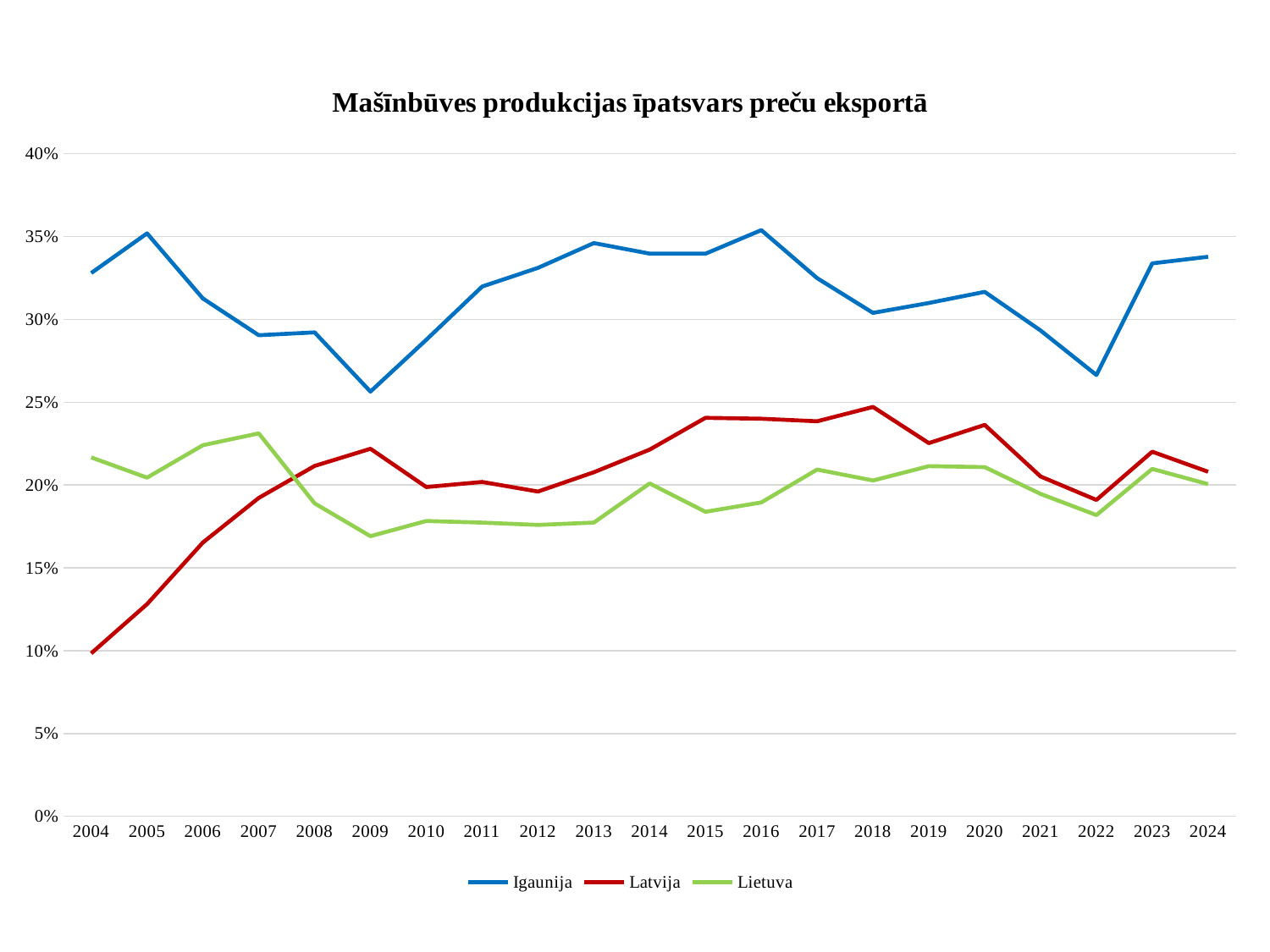
In 2007, which is higher: Latvija or Lietuva? Lietuva In which year is the Latvija line at its lowest? 2004 Does the Latvija line rise or fall from 2004 to 2007? rise In which year is the Igaunija line at its lowest? 2009 What is the title of the chart? Mašīnbūves produkcijas īpatsvars preču eksportā How many years are plotted along the x axis? 21 How many series does the legend list? 3 Is the value for Igaunija in 2009 greater or less than 30%? less Is the value for Lietuva in 2007 greater or less than 20%? greater What kind of chart is shown on the slide? line chart In which year is the Lietuva line at its highest? 2007 Is the value for Latvija in 2004 greater or less than 15%? less